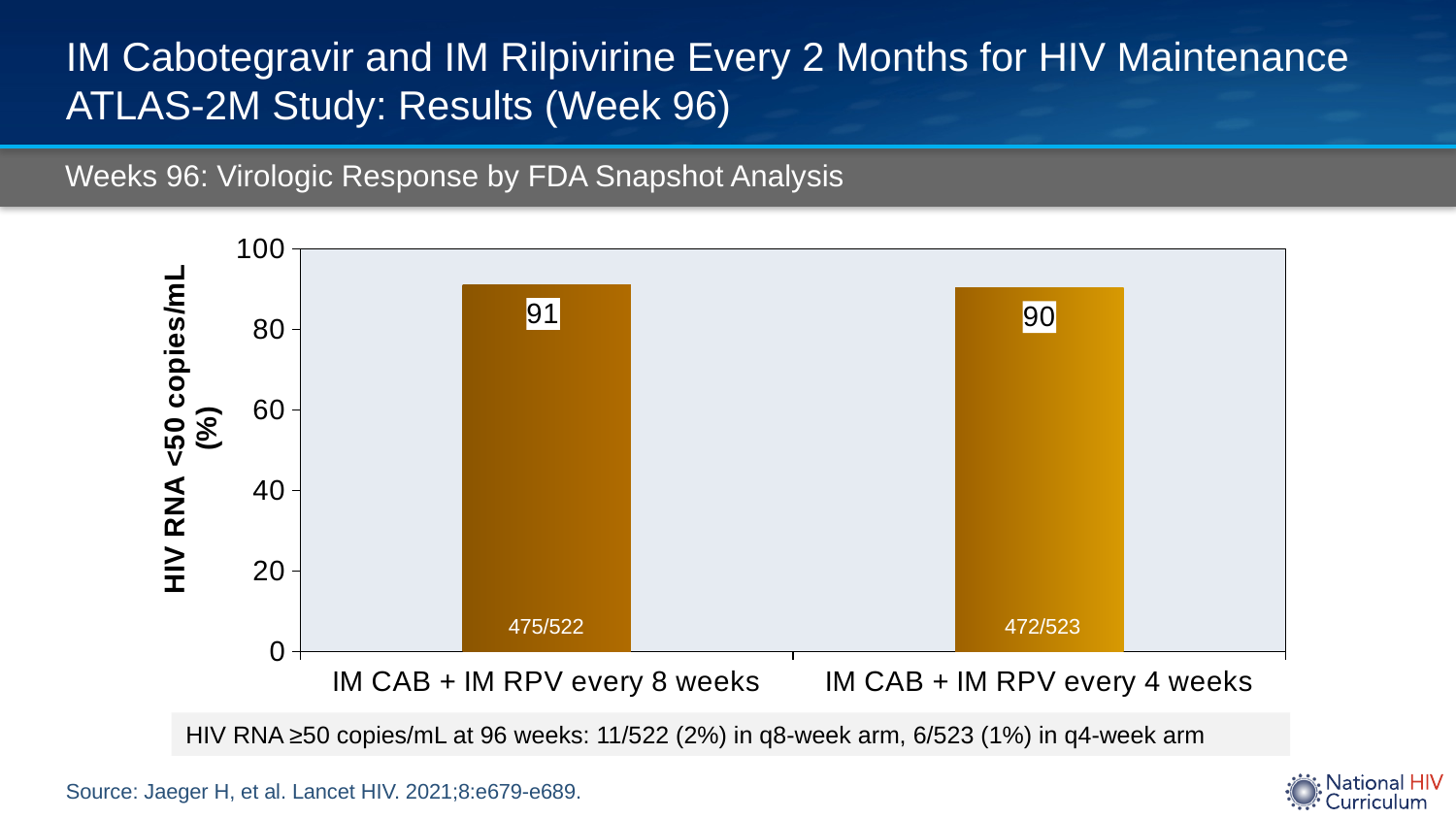
What fraction is printed inside the bar for IM CAB + IM RPV every 4 weeks? 472/523 What is the label of the y axis? HIV RNA <50 copies/mL (%) What is the difference between the values for IM CAB + IM RPV every 8 weeks and IM CAB + IM RPV every 4 weeks? 1 What kind of chart is shown on the slide? Bar chart What fraction is printed inside the bar for IM CAB + IM RPV every 8 weeks? 475/522 Is the value for IM CAB + IM RPV every 4 weeks greater or less than 80? greater What is the value for IM CAB + IM RPV every 8 weeks? 91 How many categories are shown on the x axis? 2 What is the maximum value shown on the y axis? 100 What is the value for IM CAB + IM RPV every 4 weeks? 90 Which category has the highest value? IM CAB + IM RPV every 8 weeks Which category has the lowest value? IM CAB + IM RPV every 4 weeks